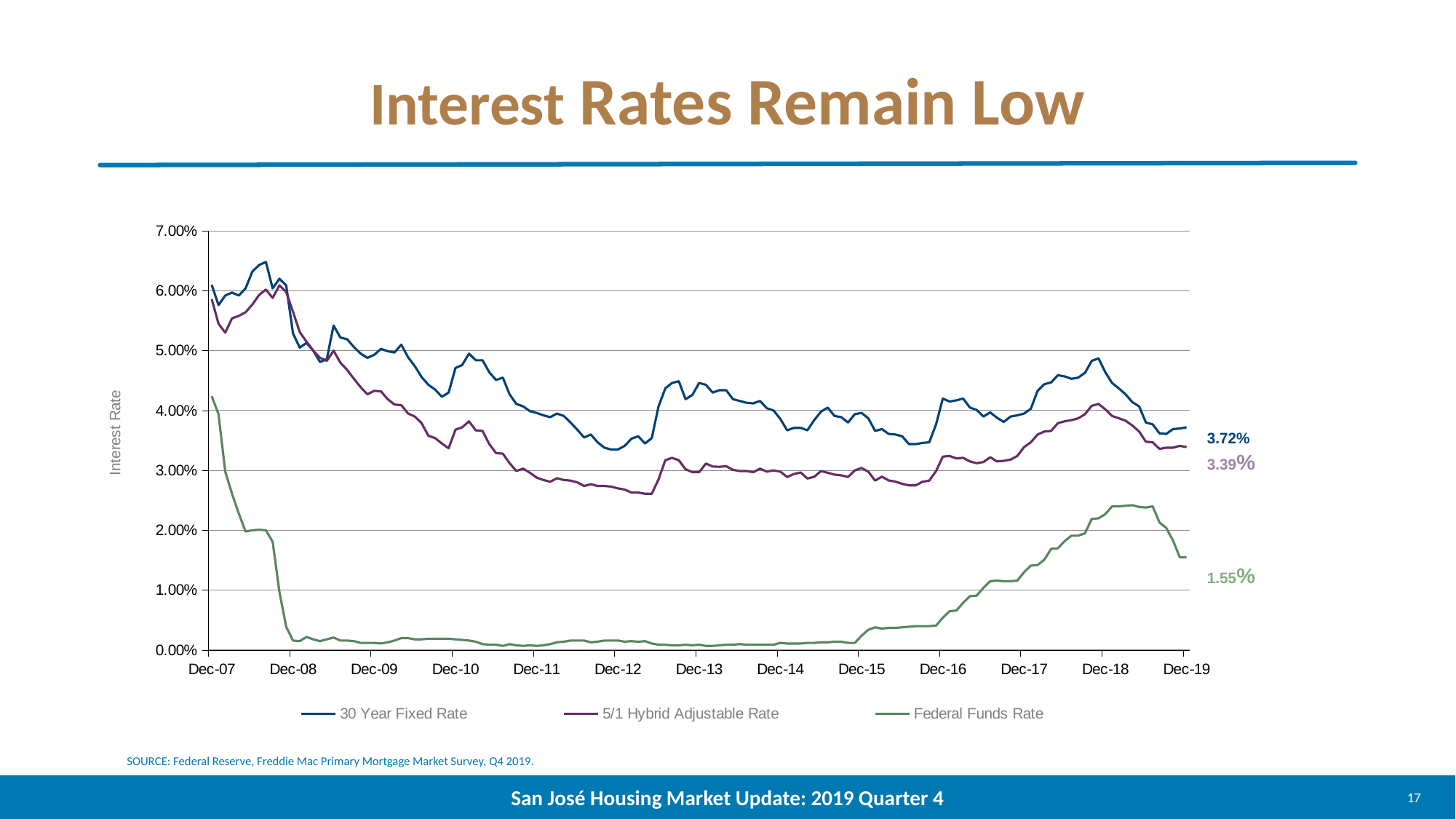
What kind of chart is shown on the slide? Line chart What is the value of the Federal Funds Rate at Dec-19? 1.55% Which series has the lowest value at Dec-19? Federal Funds Rate At Dec-19, what is the difference between the 30 Year Fixed Rate and the 5/1 Hybrid Adjustable Rate? 0.33% At Dec-19, which is larger: the 30 Year Fixed Rate or the Federal Funds Rate? 30 Year Fixed Rate Is the value of the Federal Funds Rate at Dec-12 greater or less than 1.00%? less At Dec-19, what is the difference between the 30 Year Fixed Rate and the Federal Funds Rate? 2.17% What is the title of the slide containing the chart? Interest Rates Remain Low What is the value of the 30 Year Fixed Rate at Dec-19? 3.72% Does the Federal Funds Rate rise or fall between Dec-07 and Dec-08? Fall How many series does the legend list? 3 What is the value of the 5/1 Hybrid Adjustable Rate at Dec-19? 3.39%